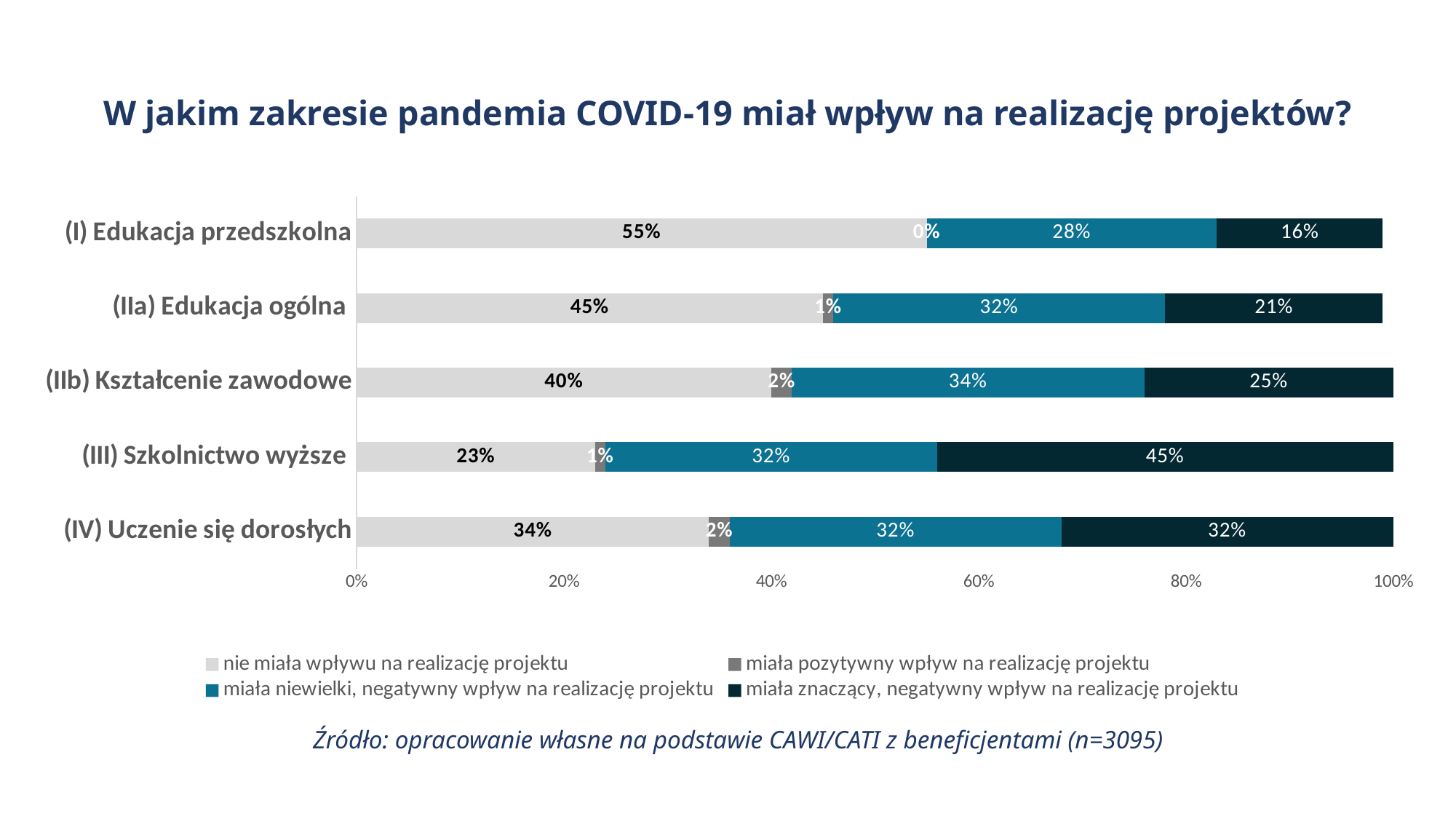
What is the source given below the chart? opracowanie własne na podstawie CAWI/CATI z beneficjentami (n=3095) What type of chart is shown on the slide? stacked bar chart What is the difference between the 'nie miała wpływu' share for (IIa) Edukacja ogólna and (III) Szkolnictwo wyższe? 22 percentage points What is the value for 'miała niewielki, negatywny wpływ na realizację projektu' for (IIb) Kształcenie zawodowe? 34% Which is larger: the 'miała znaczący, negatywny wpływ' share for (IV) Uczenie się dorosłych or for (IIb) Kształcenie zawodowe? (IV) Uczenie się dorosłych Which category has the highest share of 'nie miała wpływu na realizację projektu'? (I) Edukacja przedszkolna Which category has the lowest share of 'miała znaczący, negatywny wpływ na realizację projektu'? (I) Edukacja przedszkolna What percentage of (I) Edukacja przedszkolna projects reported that the pandemic had no impact (nie miała wpływu na realizację projektu)? 55% How many series does the legend list? 4 How many categories (education areas) are shown on the chart? 5 What is the value for 'miała znaczący, negatywny wpływ na realizację projektu' for (III) Szkolnictwo wyższe? 45% What is the total of the stacked bar for (IV) Uczenie się dorosłych? 100%